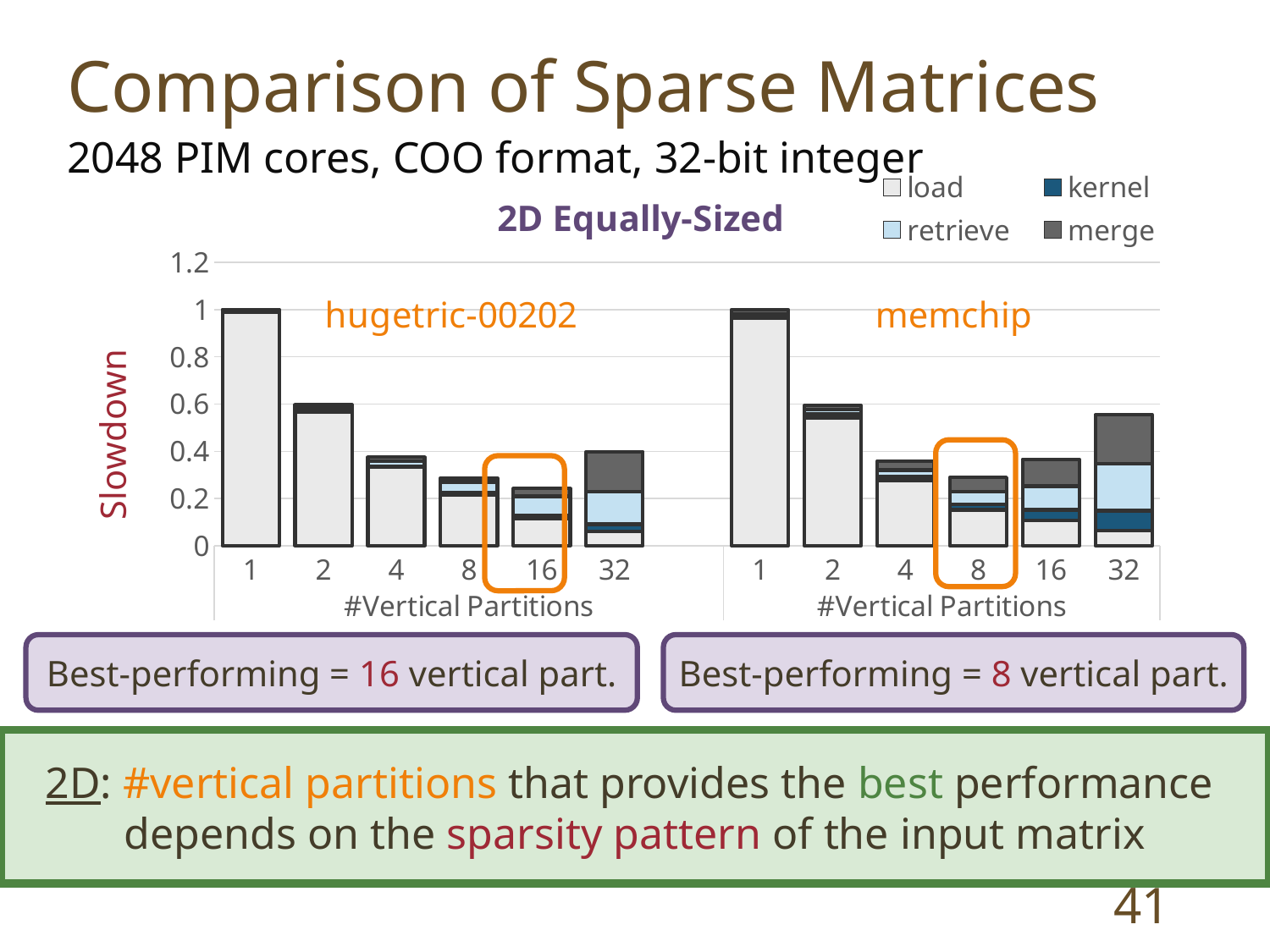
What kind of chart is shown on the slide? stacked bar chart Is the Slowdown for memchip with 32 vertical partitions greater or less than 0.4? greater What is the label on the y axis of the chart? Slowdown For hugetric-00202, which number of vertical partitions has the highest Slowdown? 1 For hugetric-00202, which number of vertical partitions has the lowest Slowdown? 16 How many #Vertical Partitions categories are plotted for the hugetric-00202 matrix? 6 What is the Slowdown value for hugetric-00202 with 1 vertical partition? 1 For memchip, which has the larger Slowdown: 16 or 32 vertical partitions? 32 Is the Slowdown for hugetric-00202 with 16 vertical partitions greater or less than 0.4? less For memchip, which number of vertical partitions has the lowest Slowdown? 8 How many series does the chart legend list? 4 For hugetric-00202, does the Slowdown rise or fall as the number of vertical partitions goes from 1 to 16? fall